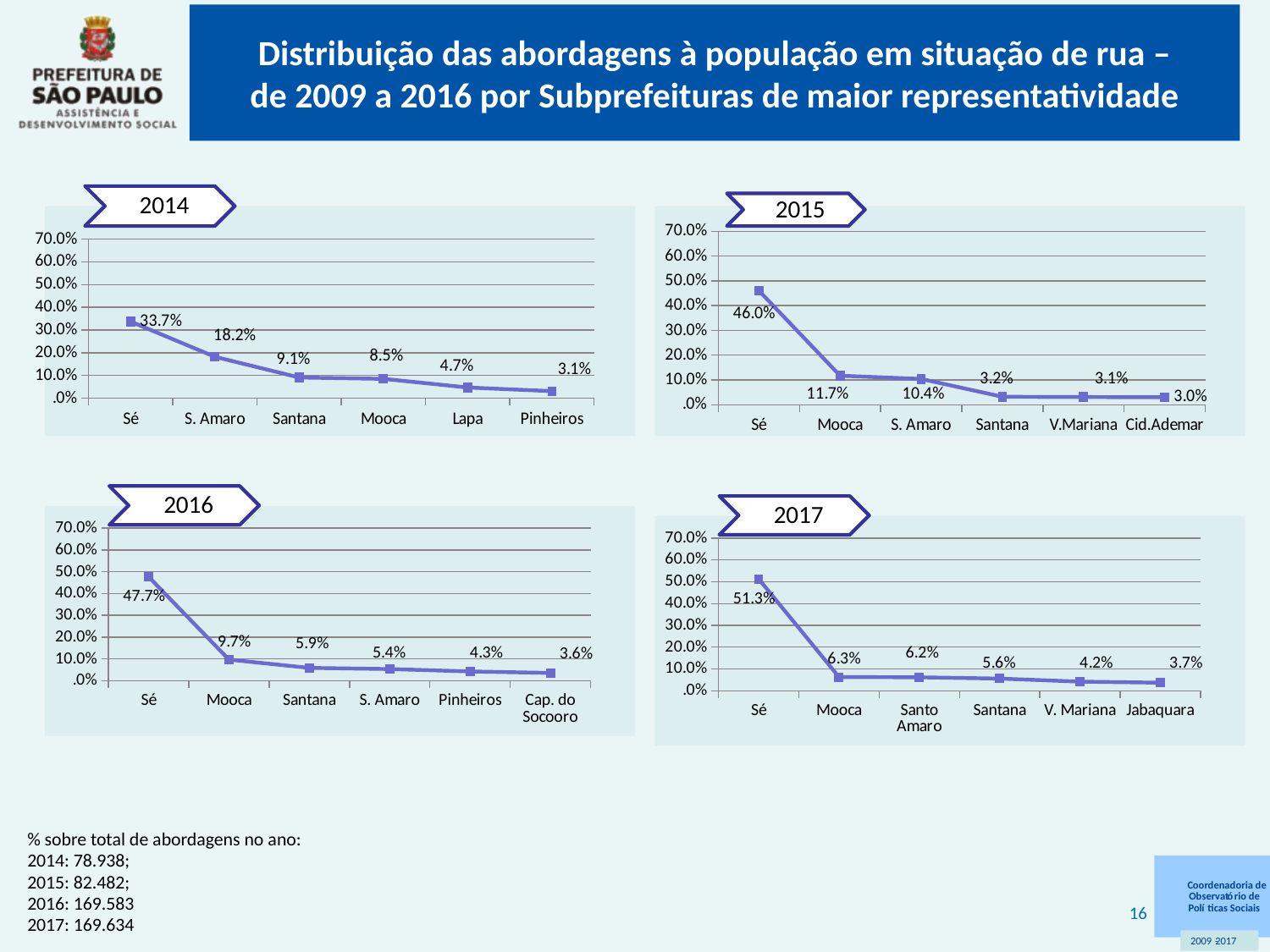
In the 2015 chart, is the value for Sé greater or less than 40.0%? greater In the 2016 chart, what is the value for Cap. do Socooro? 3.6% What kind of chart is the 2015 chart? line chart In the 2015 chart, what is the value for Mooca? 11.7% How many subprefeituras are plotted in the 2016 chart? 6 In the 2014 chart, what is the difference between the values for Sé and S. Amaro? 15.5% In the 2017 chart, do the values rise or fall from Sé to Jabaquara? fall In the 2014 chart, which subprefeitura has the lowest value? Pinheiros In the 2016 chart, which is larger, the value for Mooca or the value for Santana? Mooca In the 2014 chart, what is the value for Sé? 33.7% In the 2017 chart, which subprefeitura has the highest value? Sé In the 2017 chart, what is the value for V. Mariana? 4.2%